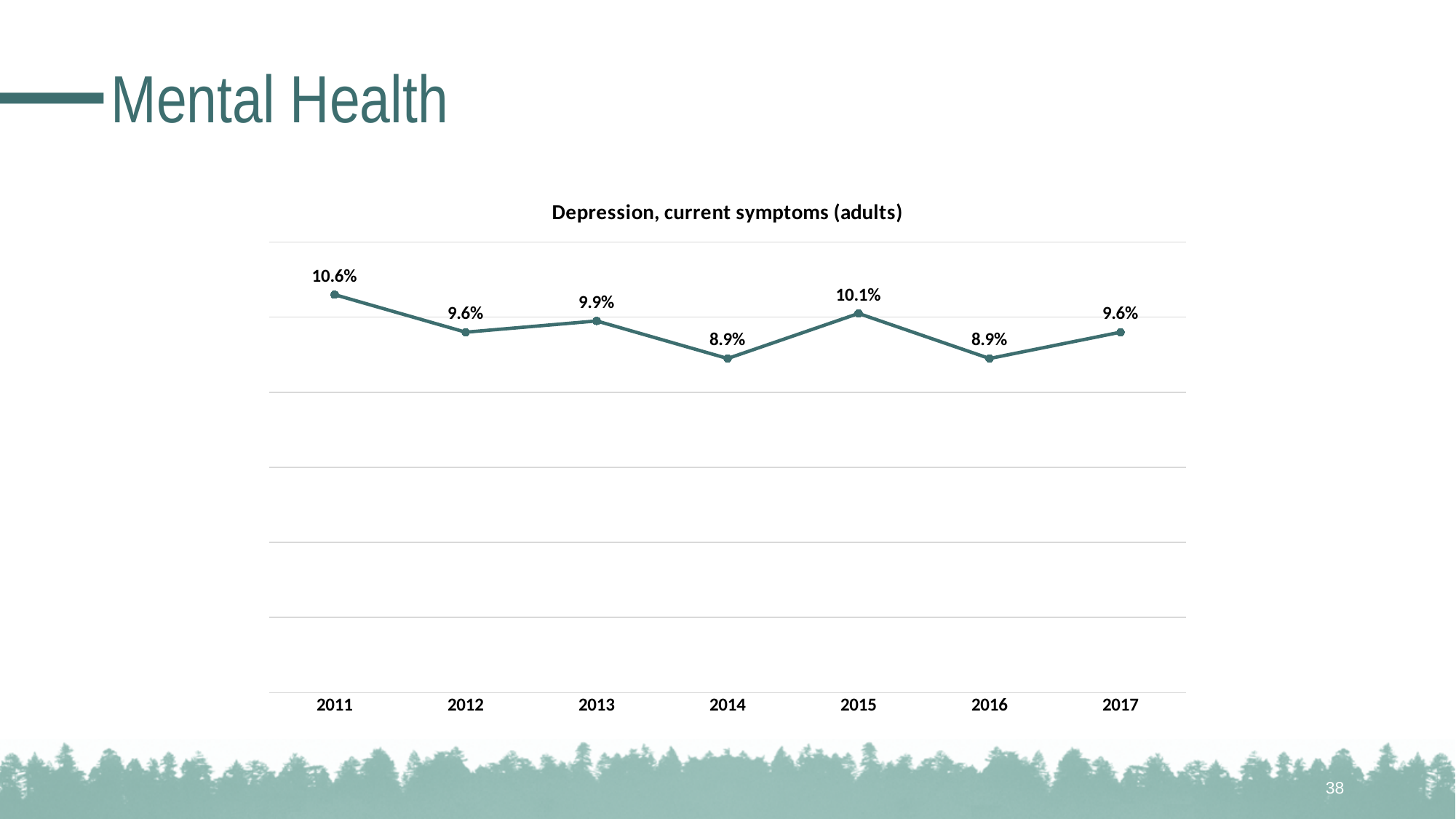
How many years are plotted on the chart? 7 What is the value for 2014? 8.9% Which is larger, the value for 2013 or the value for 2012? 2013 What is the value for 2015? 10.1% What is the title of the chart? Depression, current symptoms (adults) What is the value for 2011? 10.6% What is the difference between the values for 2015 and 2016? 1.2% Which is larger, the value for 2015 or the value for 2017? 2015 What kind of chart is shown? Line chart What is the difference between the values for 2011 and 2014? 1.7% Which year has the highest value? 2011 What is the value for 2017? 9.6%